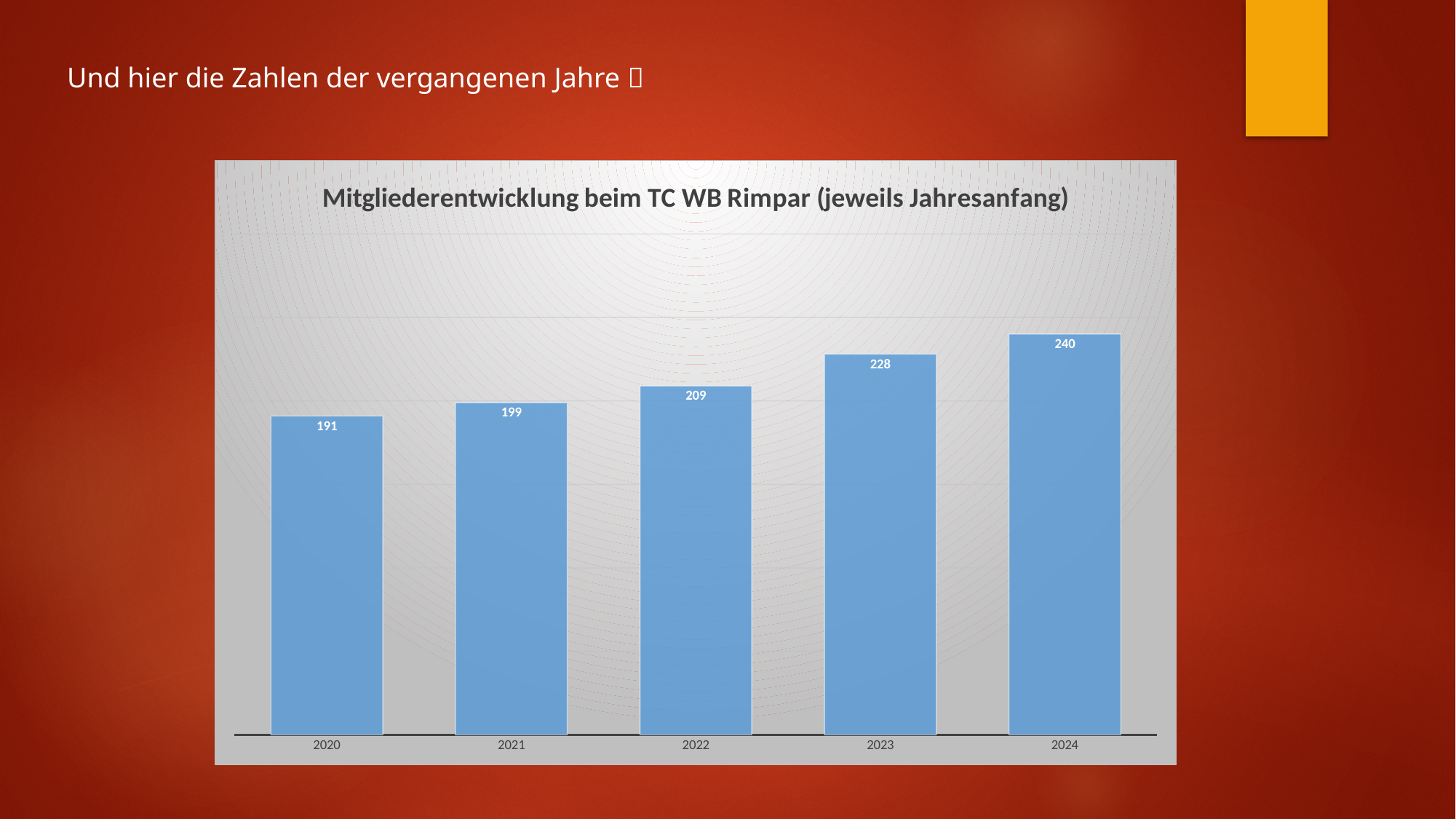
What is the value for 2020? 191 What is the difference between the values for 2024 and 2020? 49 Which year has the lowest value? 2020 What is the value for 2024? 240 What is the value for 2022? 209 What is the title of the chart? Mitgliederentwicklung beim TC WB Rimpar (jeweils Jahresanfang) What is the difference between the values for 2023 and 2022? 19 How many years are shown on the x axis? 5 What kind of chart is this? bar chart Which is larger, the value for 2021 or the value for 2023? 2023 Do the values rise or fall from 2020 to 2024? rise Which year has the highest value? 2024